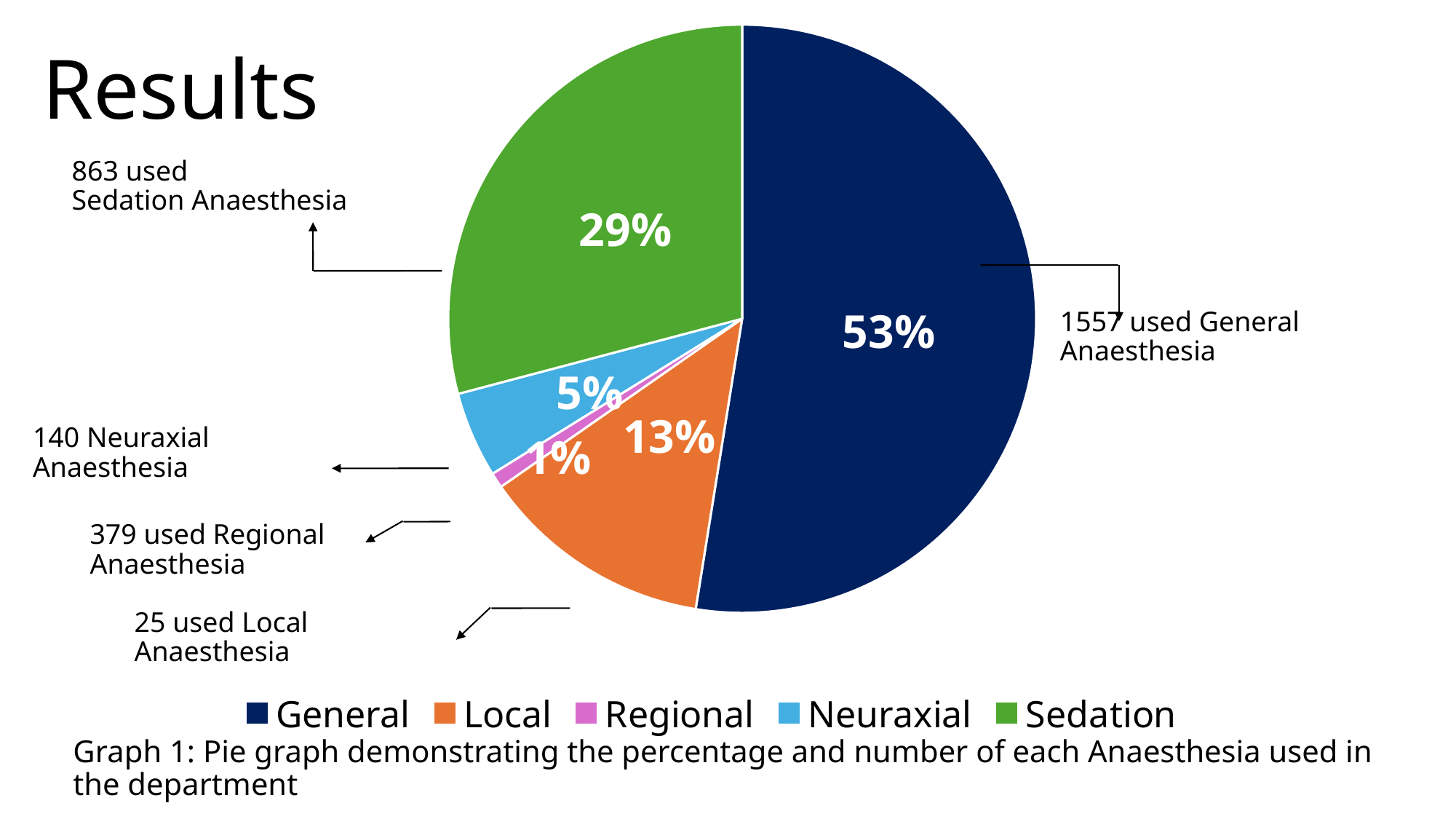
How many percentage points larger is the General slice than the Sedation slice? 24 How many slices does the pie chart have? 5 What share of the pie does Neuraxial anaesthesia represent? 5% Which anaesthesia type has the largest slice of the pie? General According to the annotation, how many patients used General Anaesthesia? 1557 What percentage of the pie is Local anaesthesia? 13% What percentage of the pie does General anaesthesia account for? 53% What colour is the General slice in the pie chart? Dark blue Which anaesthesia type has the smallest slice of the pie? Regional Which slice is larger, Local or Neuraxial? Local What kind of chart is shown on the slide? Pie chart